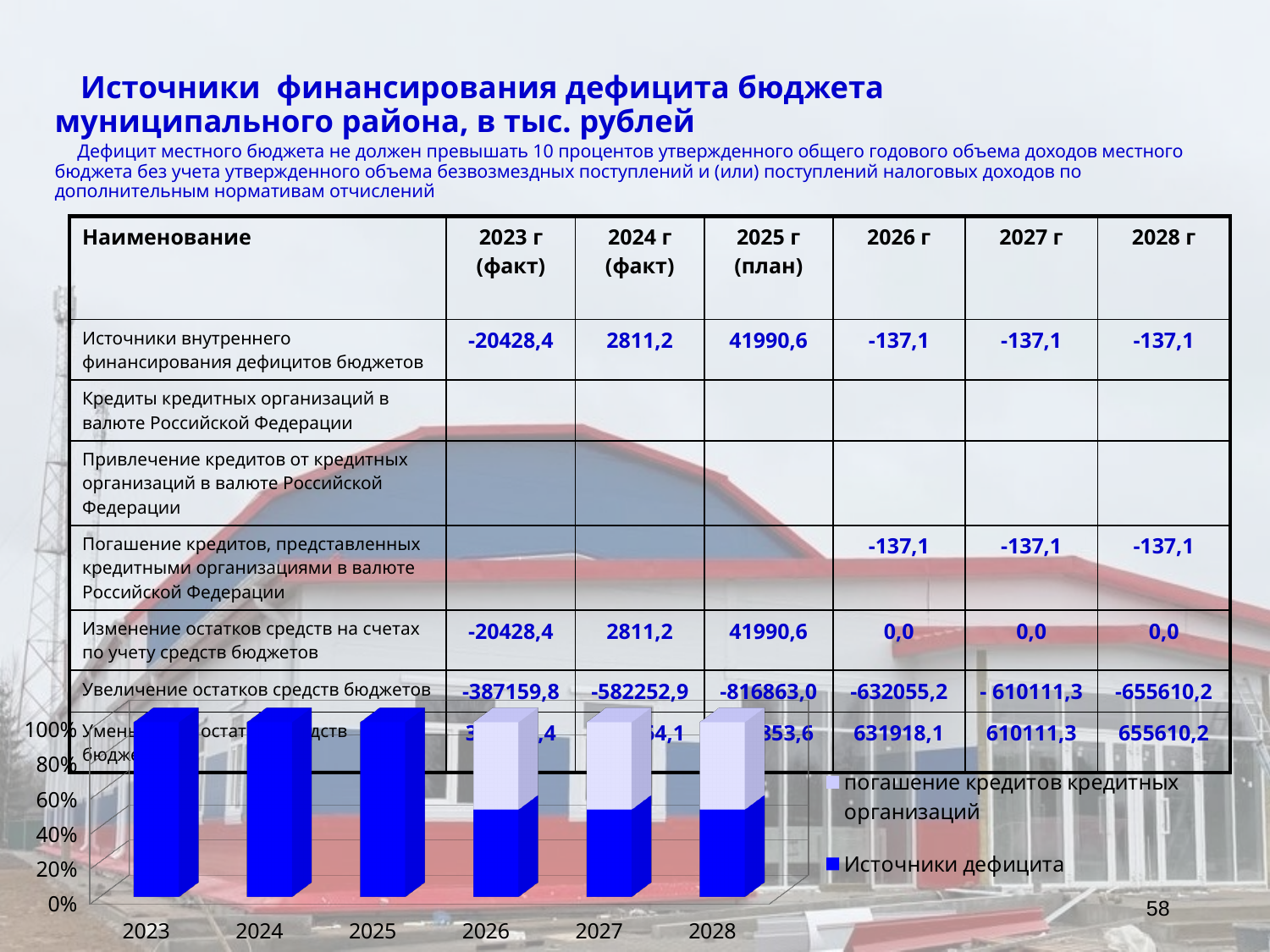
How many series does the legend of the bar chart list? 2 What is the highest value shown on the y axis of the bar chart? 100% How many years are shown along the x axis of the bar chart? 6 Which series in the bar chart is shown in dark blue? Источники дефицита What is the first year shown on the x axis of the bar chart? 2023 In the bar chart, is the share of "Источники дефицита" for 2026 greater or less than 80%? less Which series in the bar chart is shown in light lavender? погашение кредитов кредитных организаций In the bar chart, is the share of "Источники дефицита" for 2025 greater or less than 60%? greater In the bar chart, which year has a larger share of "Источники дефицита": 2024 or 2027? 2024 What kind of chart is shown at the bottom of the slide? bar chart In the bar chart, is the share of "погашение кредитов кредитных организаций" for 2028 greater or less than 20%? greater